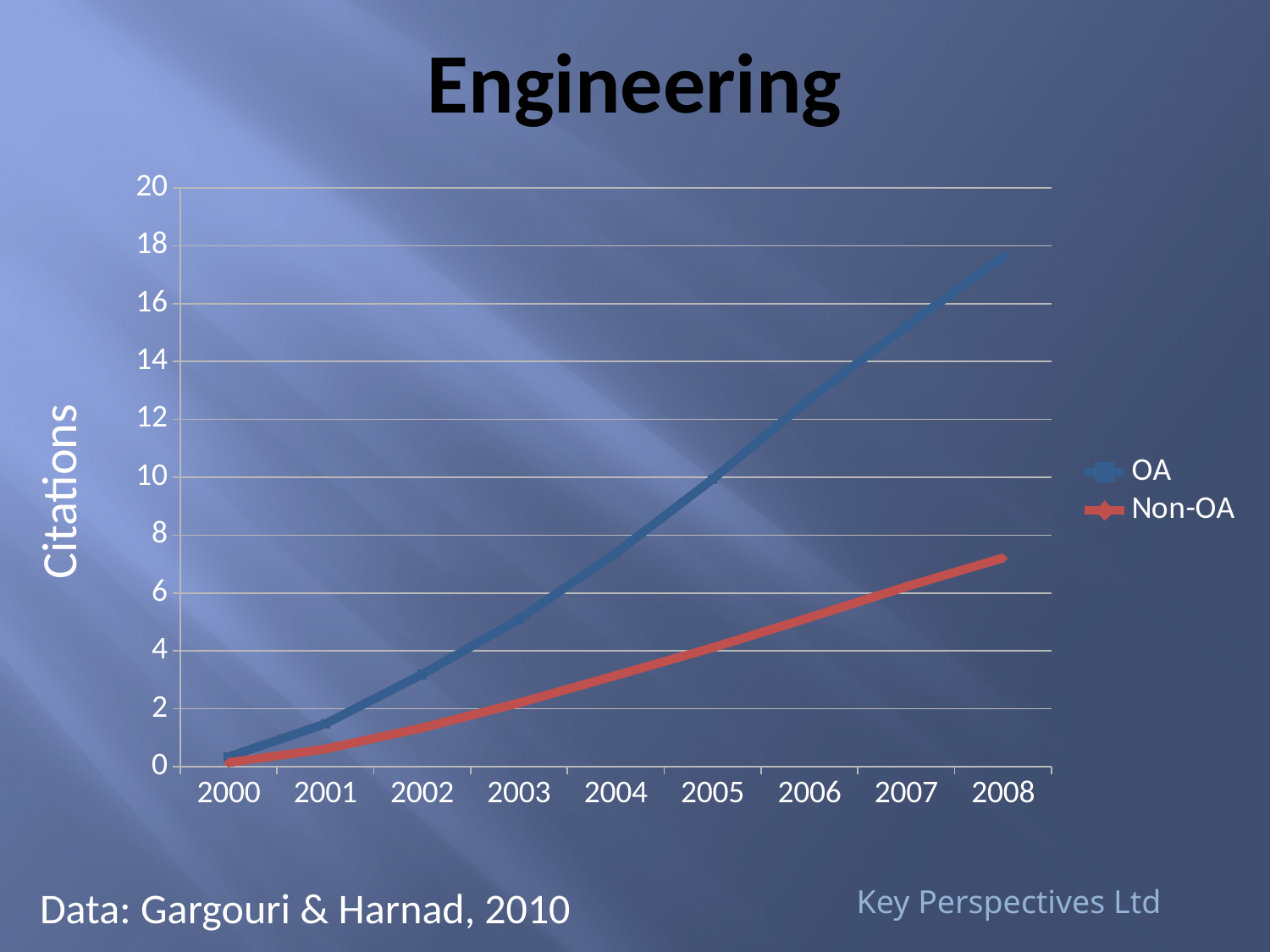
Which series has the higher value in 2008, OA or Non-OA? OA How many years are shown along the x axis? 9 In which year does the OA series reach its highest value? 2008 Is the OA value for 2008 greater or less than 16? greater What is the title of the chart? Engineering How many series does the legend list? 2 Is the OA value for 2006 greater or less than 12? greater Is the Non-OA value for 2008 greater or less than 8? less What are the two series named in the legend? OA and Non-OA What kind of chart is shown on the slide? line chart Do the OA citations rise or fall from 2000 to 2008? rise